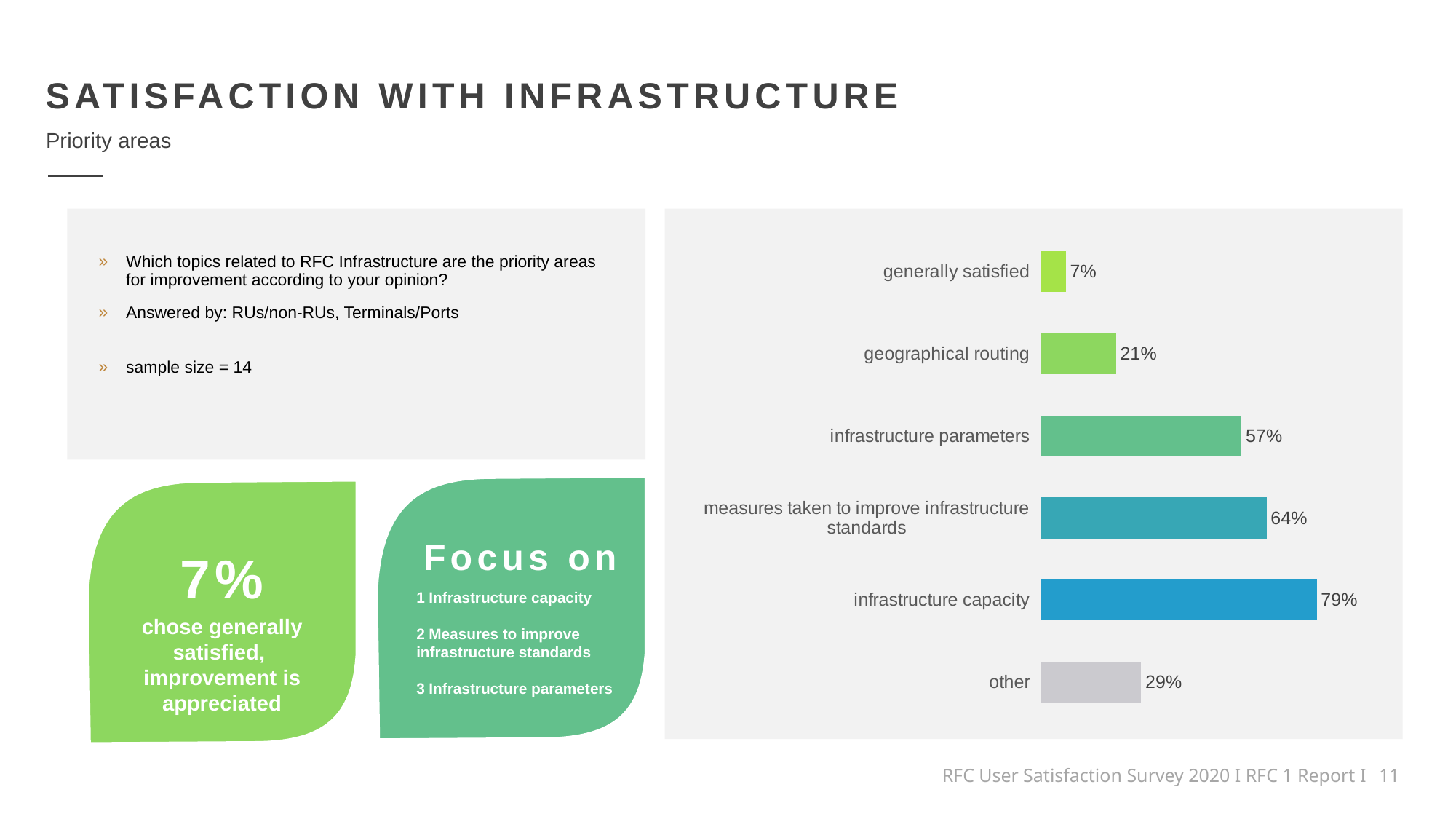
What colour is the bar for the 'other' category? grey What percentage is shown for measures taken to improve infrastructure standards? 64% How many categories are shown in the chart? 6 Which category has the lowest value in the chart? generally satisfied What is the difference between the values for 'other' and geographical routing? 8% Which is larger: the value for infrastructure parameters or the value for measures taken to improve infrastructure standards? measures taken to improve infrastructure standards Which category has the highest value in the chart? infrastructure capacity What percentage is shown for the 'other' category? 29% What is the difference between the values for infrastructure capacity and infrastructure parameters? 22% What percentage is shown for infrastructure capacity? 79% What percentage is shown for geographical routing? 21% What type of chart is shown on the slide? bar chart